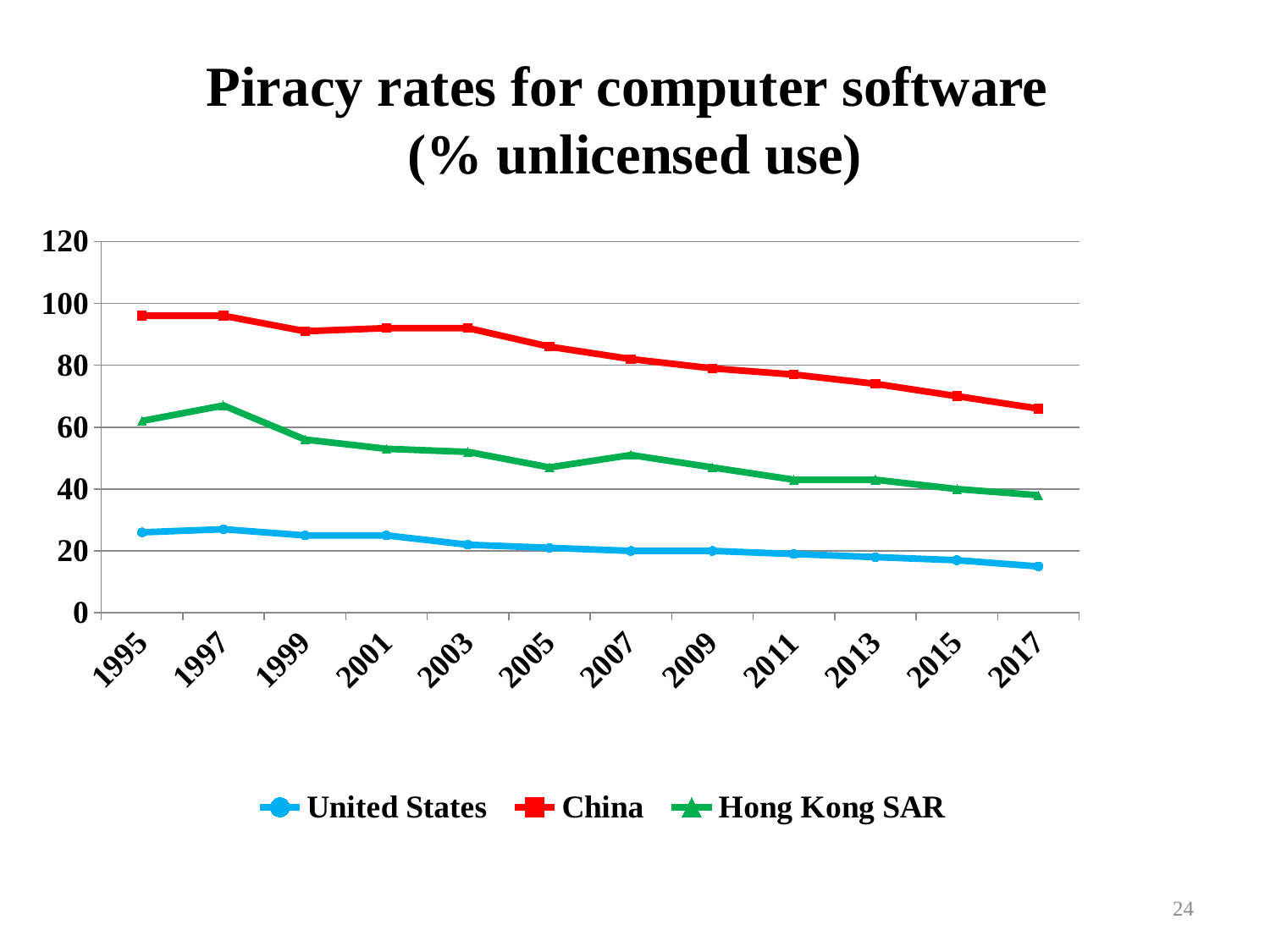
How many series does the legend list? 3 Which colour is used for the Hong Kong SAR line? green Is the value for Hong Kong SAR in 1997 greater or less than 60? greater Which series has the lowest piracy rate in 1995? United States Which is larger in 2017, the value for China or the value for the United States? China Is the value for China in 1995 greater or less than 80? greater Is the value for China in 2017 greater or less than 60? greater Which series has the highest piracy rate in 2017? China What kind of chart is shown on the slide? line chart What is the title of the chart? Piracy rates for computer software (% unlicensed use) Do the values for China rise or fall from 1995 to 2017? fall